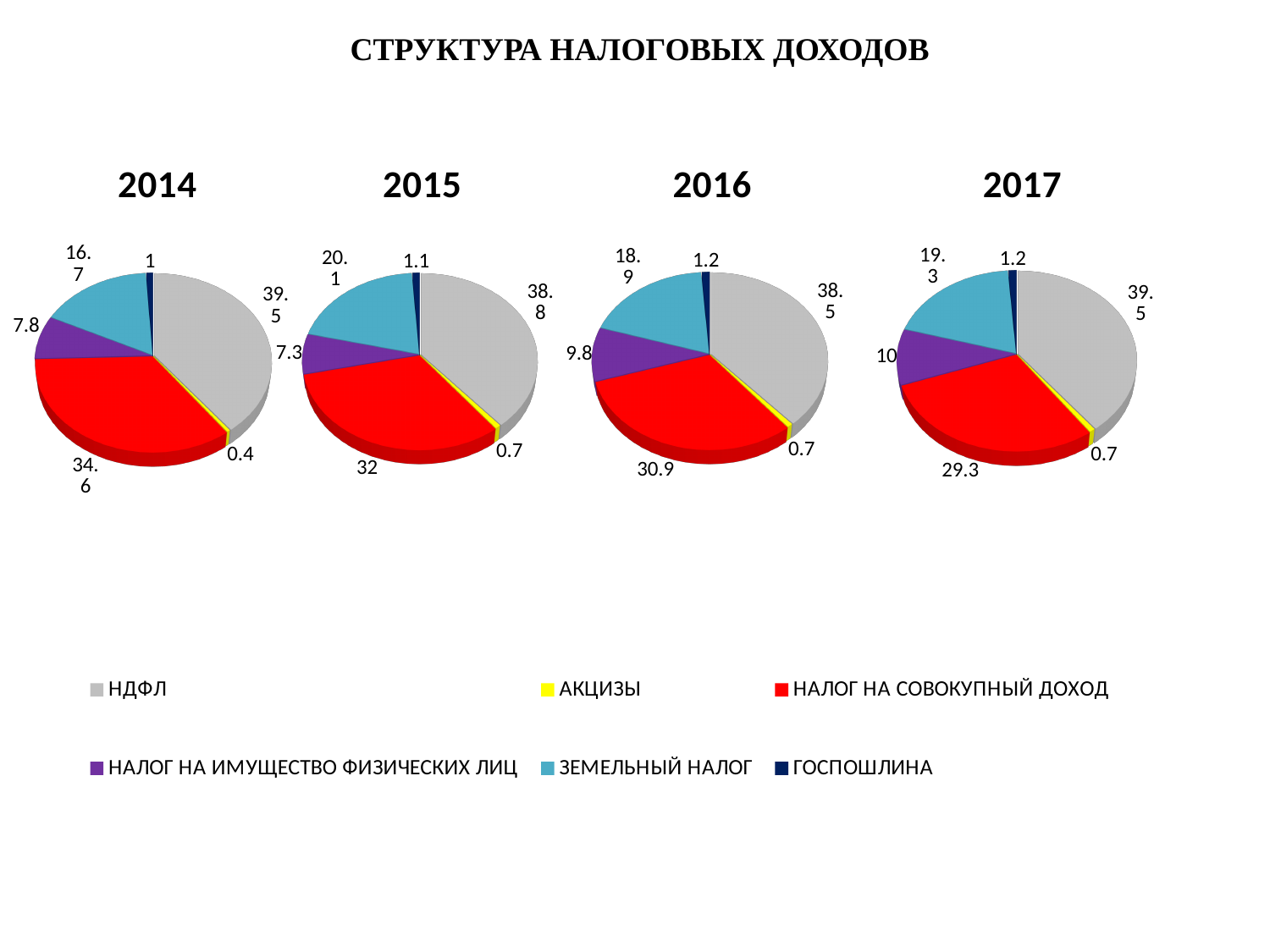
In the 2016 pie chart, which category has the largest slice? НДФЛ In the 2014 pie chart, what is the value for НДФЛ? 39.5 How many categories does the legend list? 6 In the 2015 pie chart, what is the value for ЗЕМЕЛЬНЫЙ НАЛОГ? 20.1 In the 2017 pie chart, what is the value for НАЛОГ НА СОВОКУПНЫЙ ДОХОД? 29.3 In the 2017 pie chart, which is larger: ЗЕМЕЛЬНЫЙ НАЛОГ or НАЛОГ НА ИМУЩЕСТВО ФИЗИЧЕСКИХ ЛИЦ? ЗЕМЕЛЬНЫЙ НАЛОГ In the 2016 pie chart, what is the value for НАЛОГ НА ИМУЩЕСТВО ФИЗИЧЕСКИХ ЛИЦ? 9.8 What type of chart is used for each year on the slide? Pie chart Across the charts from 2014 to 2017, does the value for НАЛОГ НА СОВОКУПНЫЙ ДОХОД rise or fall? Fall In the 2014 pie chart, which category has the smallest slice? АКЦИЗЫ How many pie charts are shown on the slide? 4 In the 2015 pie chart, what is the difference between the values for НДФЛ and НАЛОГ НА СОВОКУПНЫЙ ДОХОД? 6.8